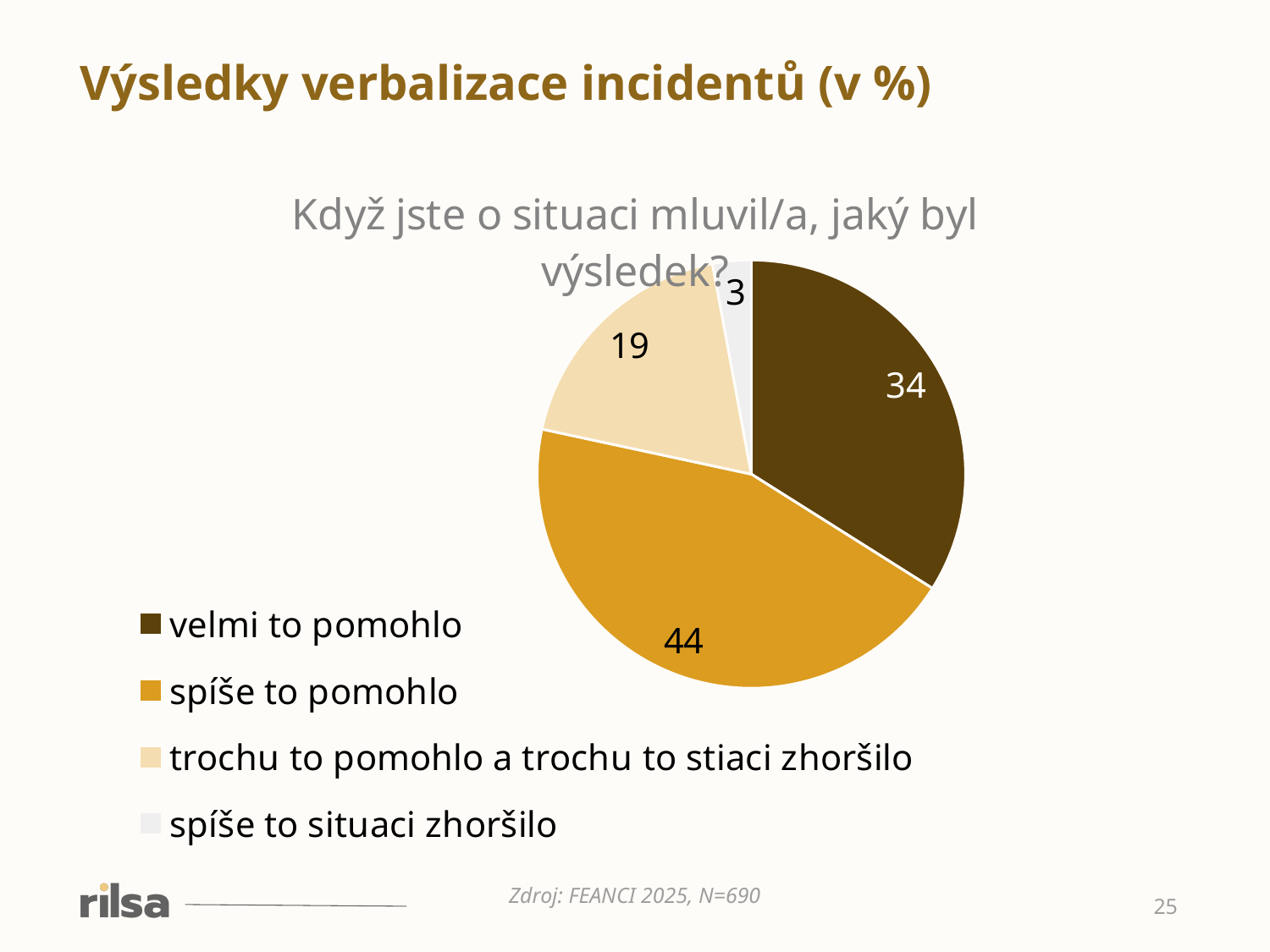
What is the value for "trochu to pomohlo a trochu to stiaci zhoršilo"? 19 Which is larger, the value for "velmi to pomohlo" or the value for "trochu to pomohlo a trochu to stiaci zhoršilo"? velmi to pomohlo What type of chart is shown on the slide? pie chart What is the combined value of "velmi to pomohlo" and "spíše to pomohlo"? 78 What is the value for "spíše to pomohlo"? 44 What is the value for "spíše to situaci zhoršilo"? 3 How many categories does the pie chart have? 4 Which category has the largest slice of the pie? spíše to pomohlo What is the value for "velmi to pomohlo"? 34 What is the title of the chart? Když jste o situaci mluvil/a, jaký byl výsledek? Which category has the smallest slice of the pie? spíše to situaci zhoršilo What is the difference between the values for "spíše to pomohlo" and "velmi to pomohlo"? 10